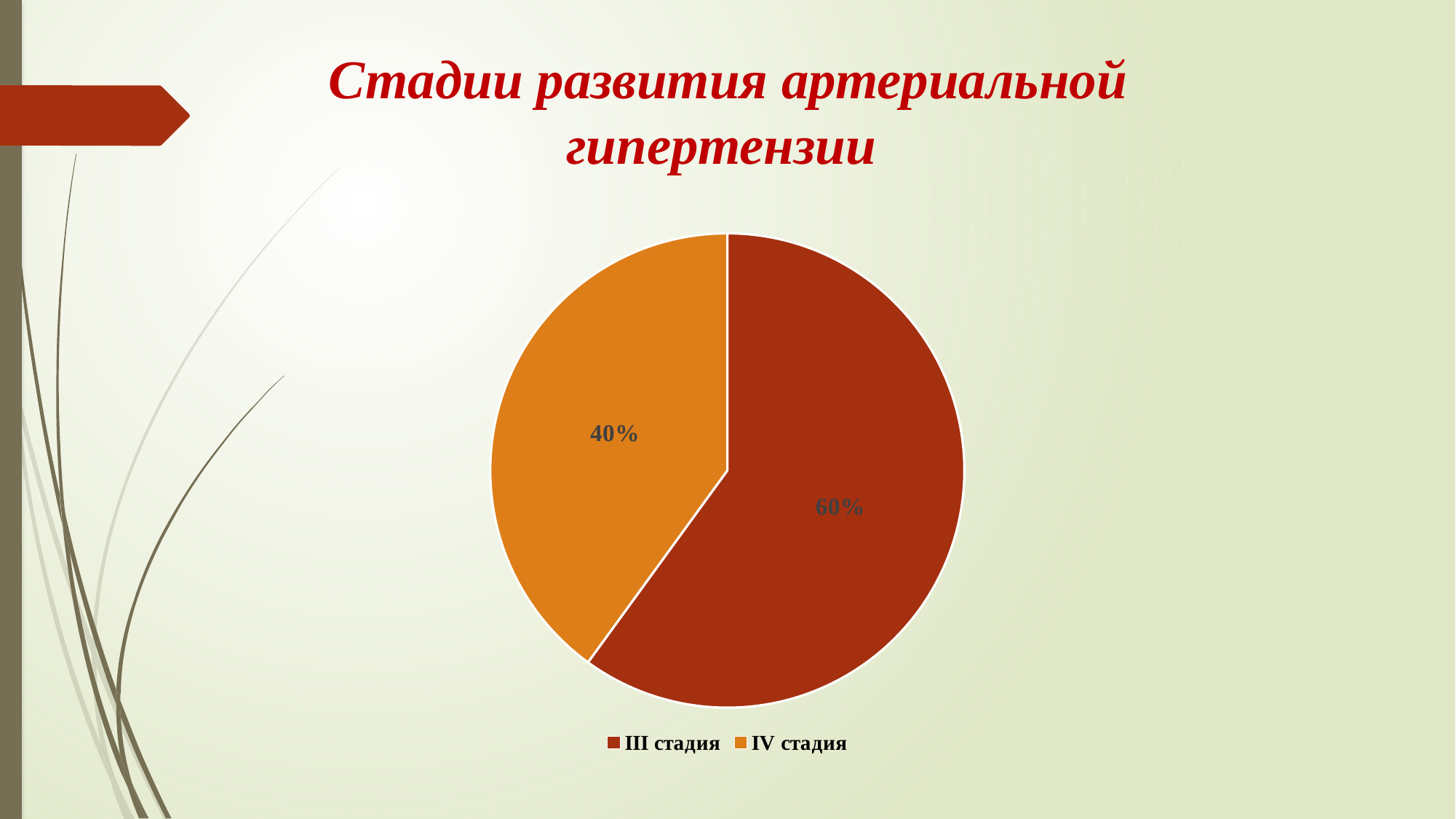
Which slice is larger, III стадия or IV стадия? III стадия What is the title of the slide containing the chart? Стадии развития артериальной гипертензии What is the difference in percentage points between the III стадия and IV стадия slices? 20% What share of the pie does IV стадия take? 40% What share of the pie does III стадия take? 60% What kind of chart is shown on the slide? pie chart What is the total of the two slice percentages shown? 100% Which category has the smallest slice of the pie? IV стадия Which category has the largest slice of the pie? III стадия What colour is the slice for IV стадия? orange How many slices does the pie chart have? 2 How many entries does the legend list? 2